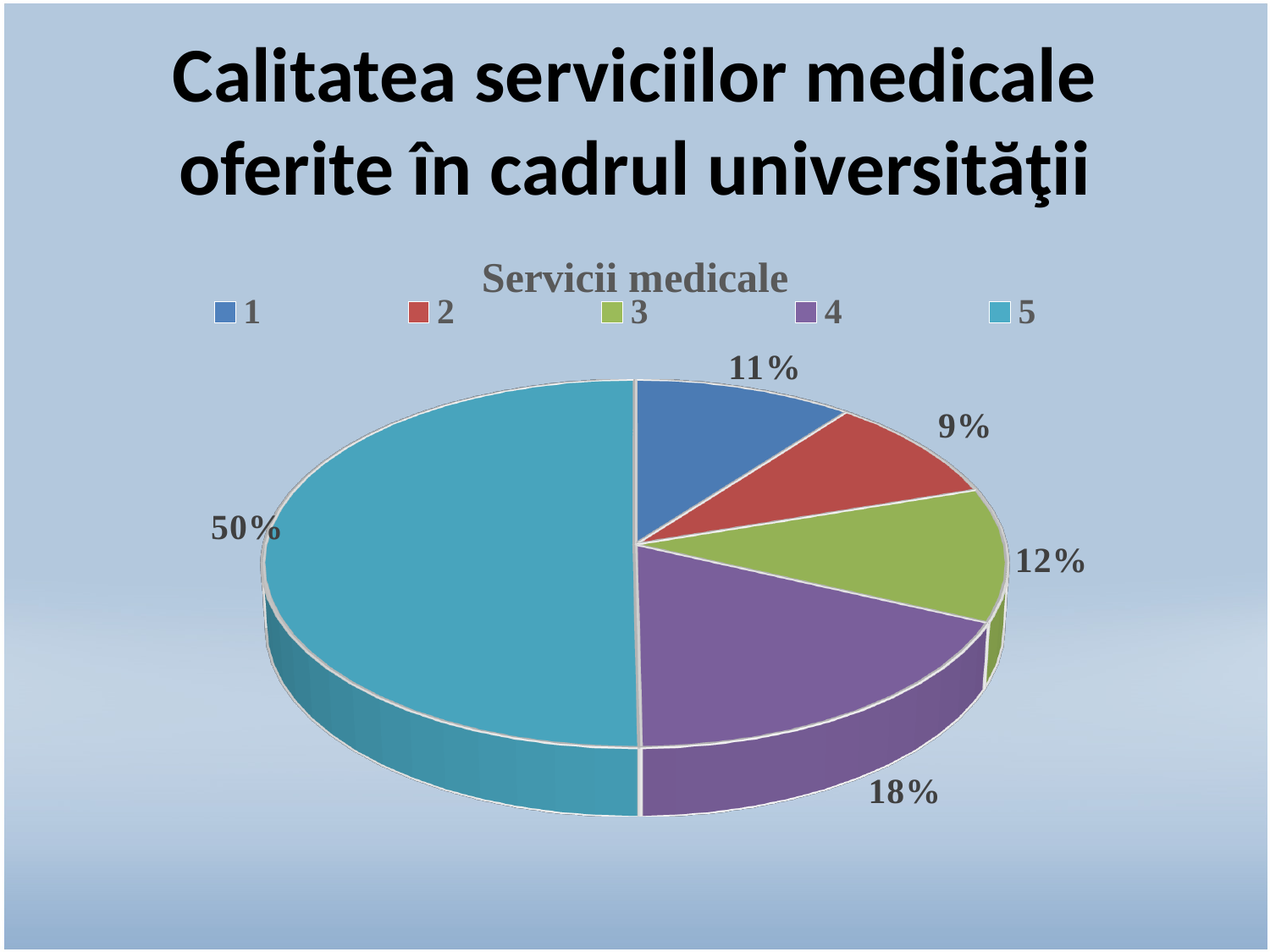
What is the difference between the values for category 4 and category 3? 6% Which is larger, the value for category 1 or category 3? category 3 What is the value for category 2? 9% How many categories does the legend list? 5 Which category has the smallest slice? 2 What is the value for category 1? 11% Which category has the largest slice? 5 What kind of chart is shown on the slide? pie chart What is the value for category 4? 18% What is the value for category 3? 12% What is the chart's title? Servicii medicale What share of the pie does category 5 have? 50%